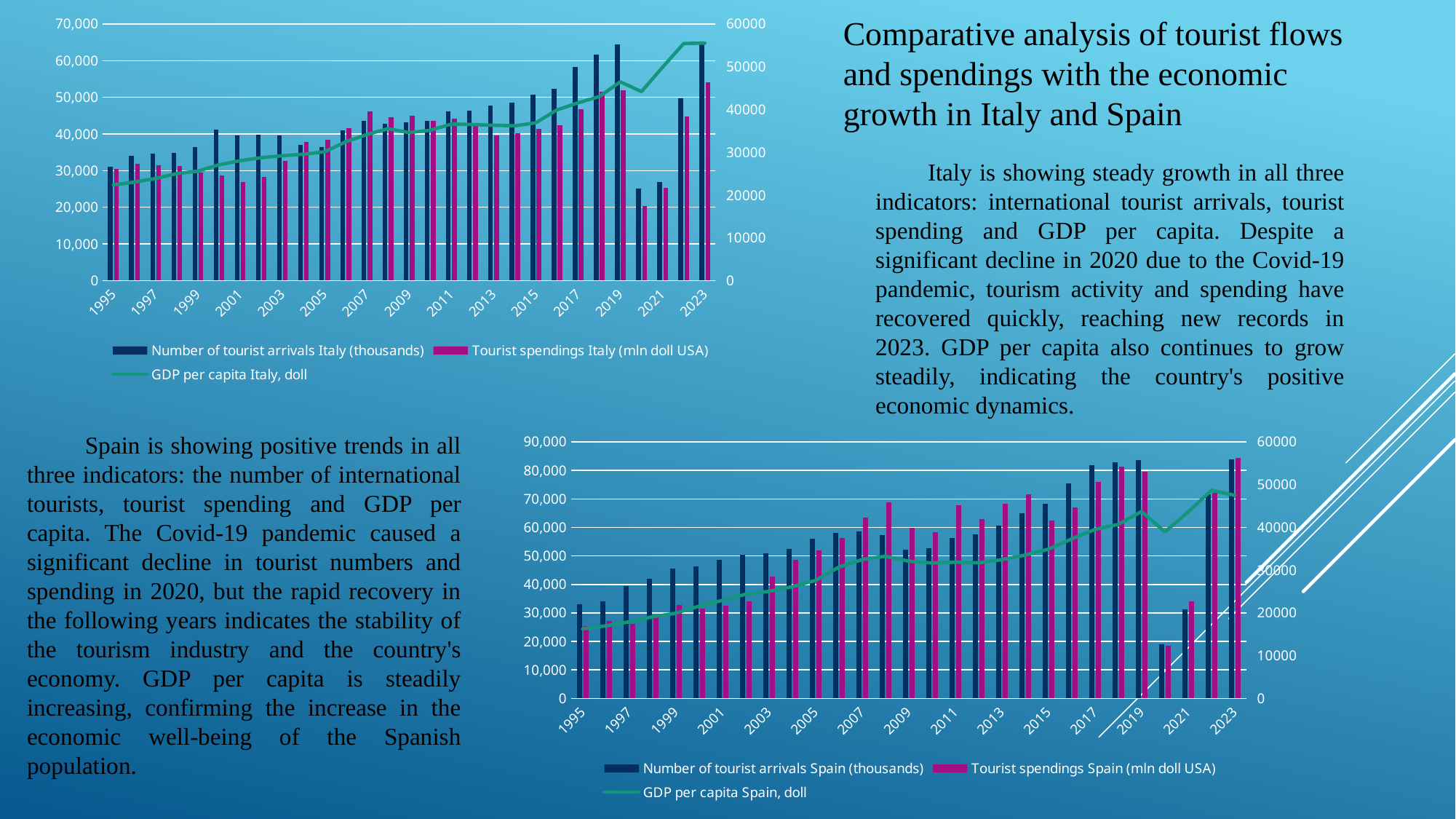
In the Italy chart, is the number of tourist arrivals Italy (thousands) in 2019 greater or less than 60,000? greater How many series does the legend of the Spain chart at the bottom right list? 3 In the Spain chart, which year has the larger number of tourist arrivals Spain (thousands), 2020 or 2021? 2021 In the Italy chart, in which year is the number of tourist arrivals Italy (thousands) lowest? 2020 What kind of chart is the Italy chart at the top left of the slide? Combination bar and line chart In the Spain chart, what is the first year shown on the x axis? 1995 In the Italy chart, is the number of tourist arrivals Italy (thousands) in 2020 greater or less than 30,000? less In the Spain chart, in which year is the number of tourist arrivals Spain (thousands) lowest? 2020 In the Italy chart, which series is drawn as a green line? GDP per capita Italy, doll In the Spain chart, is the number of tourist arrivals Spain (thousands) in 2023 greater or less than 80,000? greater In the Italy chart, does GDP per capita Italy generally rise or fall from 1995 to 2023? rise